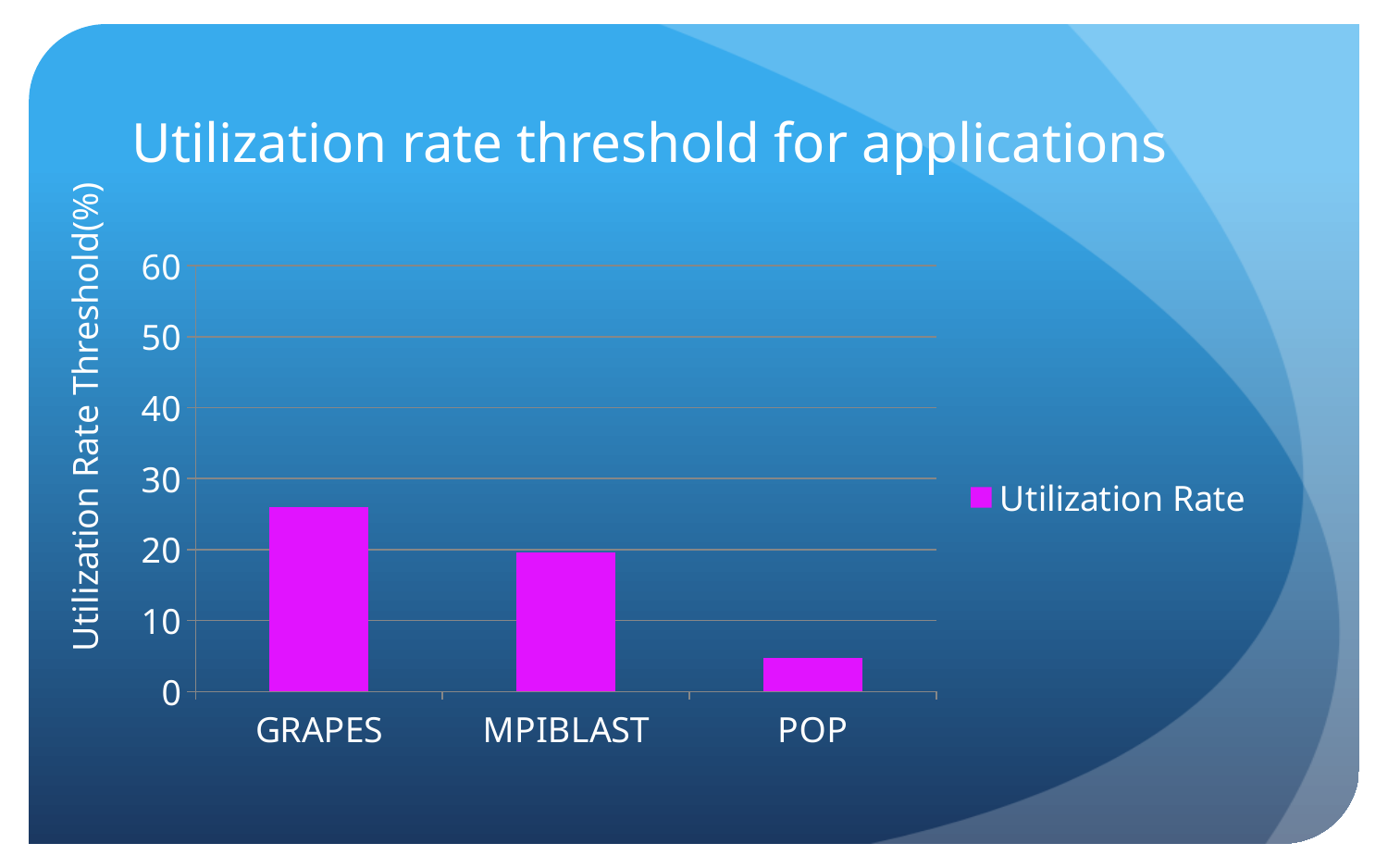
What is the title of the chart? Utilization rate threshold for applications How many applications are shown on the x axis? 3 How many series does the legend list? 1 What kind of chart is shown on the slide? bar chart Is the value for MPIBLAST greater or less than 30? less Is the value for GRAPES greater or less than 20? greater What is the label of the y axis? Utilization Rate Threshold(%) Do the values rise or fall from GRAPES to POP along the x axis? fall Which application has the lowest utilization rate threshold? POP Which is larger, the value for GRAPES or the value for MPIBLAST? GRAPES Is the value for POP greater or less than 10? less Which application has the highest utilization rate threshold? GRAPES